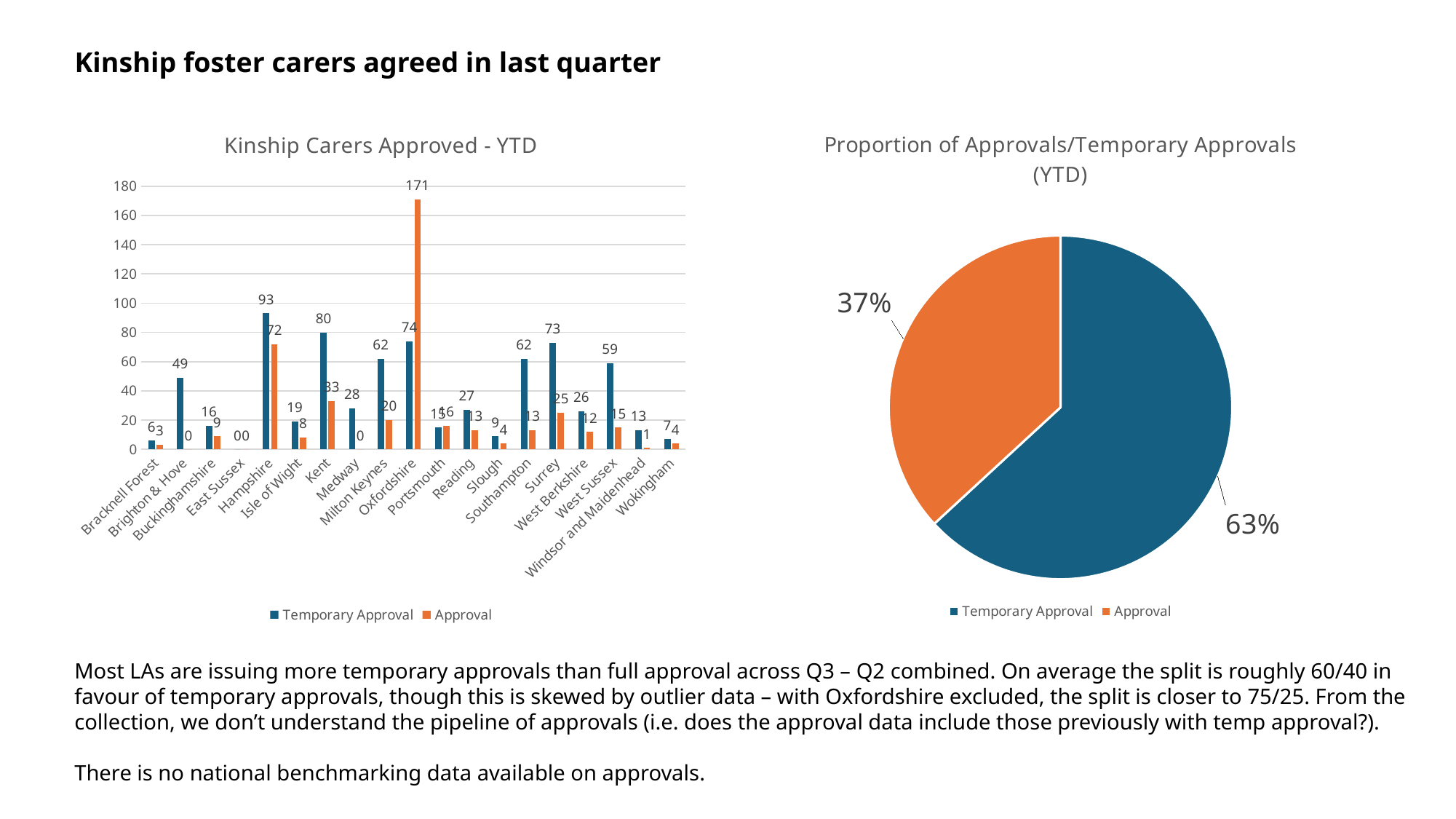
In the 'Kinship Carers Approved - YTD' chart, which local authority has the highest Approval value? Oxfordshire In the 'Kinship Carers Approved - YTD' chart, what is the Approval value for Oxfordshire? 171 In the 'Kinship Carers Approved - YTD' chart, what is the Temporary Approval value for Hampshire? 93 How many series does the legend of the 'Kinship Carers Approved - YTD' chart list? 2 How many local authorities are shown on the x axis of the 'Kinship Carers Approved - YTD' chart? 19 In the 'Kinship Carers Approved - YTD' chart, what is the difference between the Temporary Approval and Approval values for Hampshire? 21 In the 'Proportion of Approvals/Temporary Approvals (YTD)' pie chart, what share is Temporary Approval? 63% In the 'Kinship Carers Approved - YTD' chart, which has the larger Temporary Approval value, Surrey or Southampton? Surrey In the 'Kinship Carers Approved - YTD' chart, what is the Temporary Approval value for Kent? 80 What kind of chart is 'Kinship Carers Approved - YTD'? Bar chart In the 'Kinship Carers Approved - YTD' chart, which local authority has the highest Temporary Approval value? Hampshire In the 'Kinship Carers Approved - YTD' chart, what is the difference between the Temporary Approval and Approval values for Kent? 47